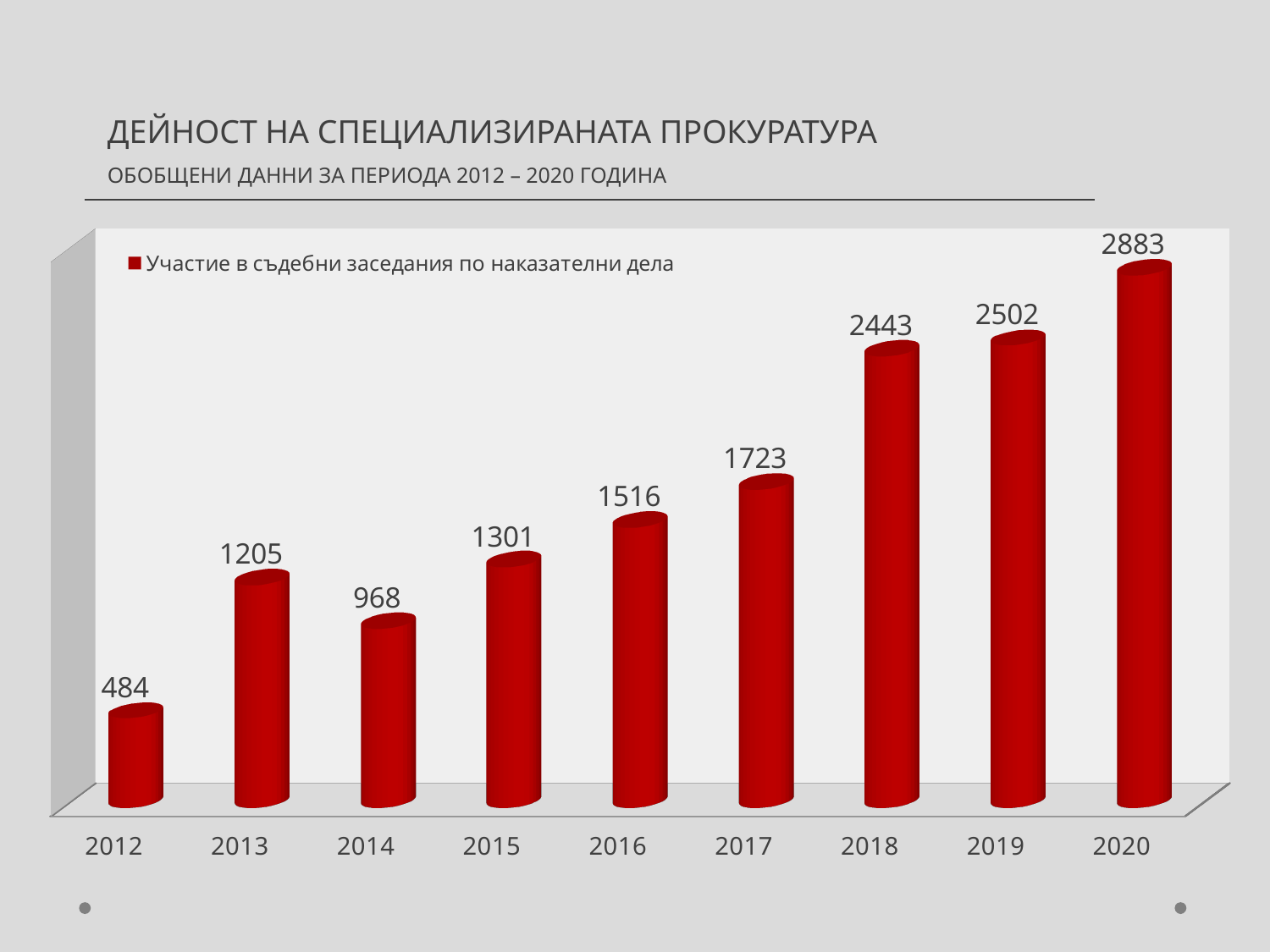
What is the value for 2020? 2883 What is the value for 2017? 1723 Which year has the lowest value? 2012 What kind of chart is shown on the slide? bar chart What is the difference between the values for 2013 and 2014? 237 How many series does the legend list? 1 What is the difference between the values for 2020 and 2019? 381 How many years are shown on the x axis? 9 What is the legend entry for the series shown? Участие в съдебни заседания по наказателни дела What is the value for 2012? 484 Which is larger, the value for 2013 or the value for 2014? 2013 Which year has the highest value? 2020